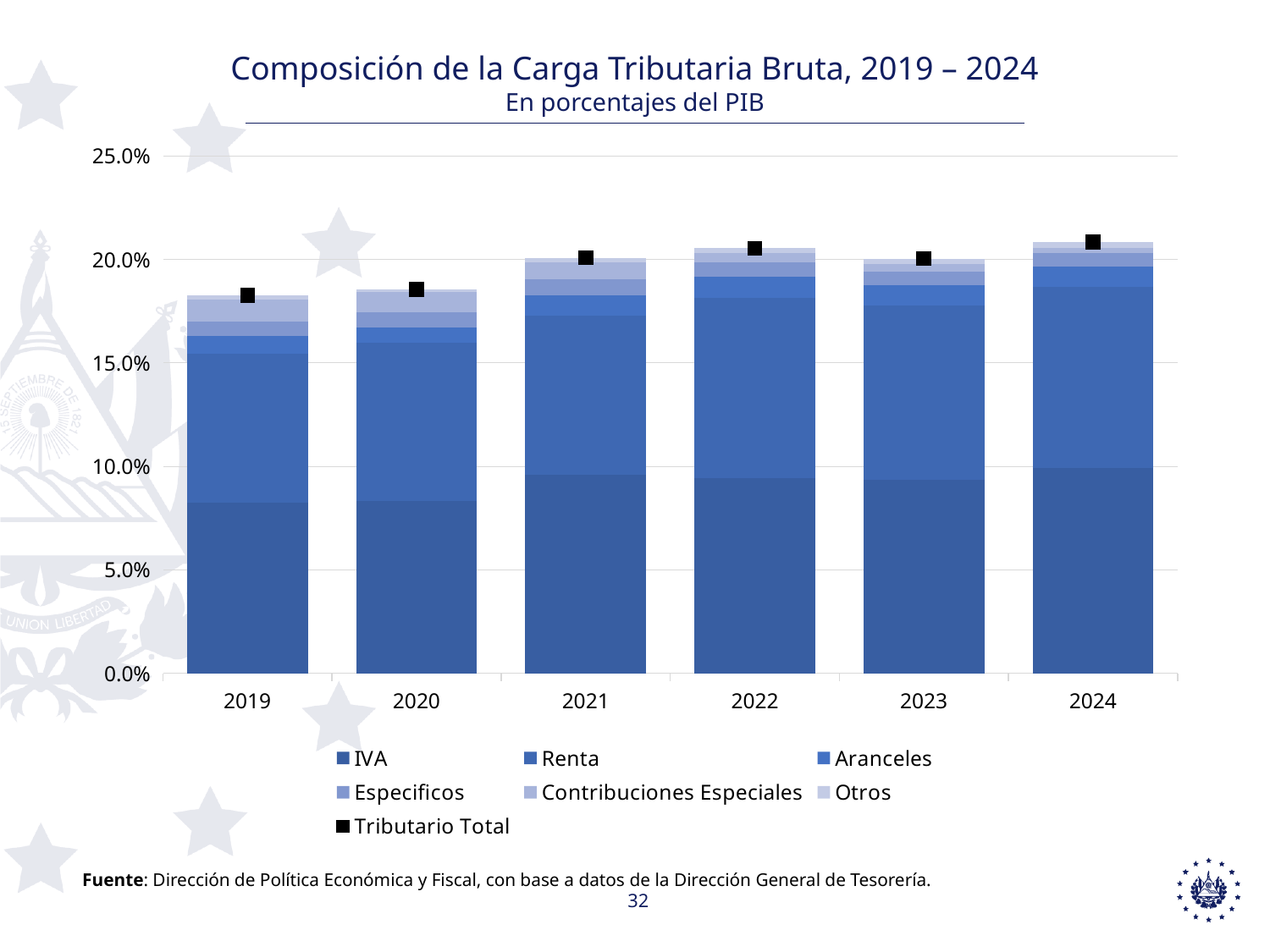
Do the Tributario Total values generally rise or fall from 2019 to 2024? rise What kind of chart is shown on the slide? Stacked bar chart How many series does the chart's legend list? 7 Is the Tributario Total value for 2024 greater or less than 20.0%? greater Which year has the highest Tributario Total value? 2024 Which year has the lowest Tributario Total value? 2019 How many years are shown on the x axis of the chart? 6 In what unit are the values expressed, according to the chart's subtitle? En porcentajes del PIB Is the Tributario Total value for 2019 greater or less than 20.0%? less What is the title of the chart? Composición de la Carga Tributaria Bruta, 2019 – 2024 Is the IVA value for 2019 greater or less than 10.0%? less Which year has a larger IVA value, 2019 or 2021? 2021